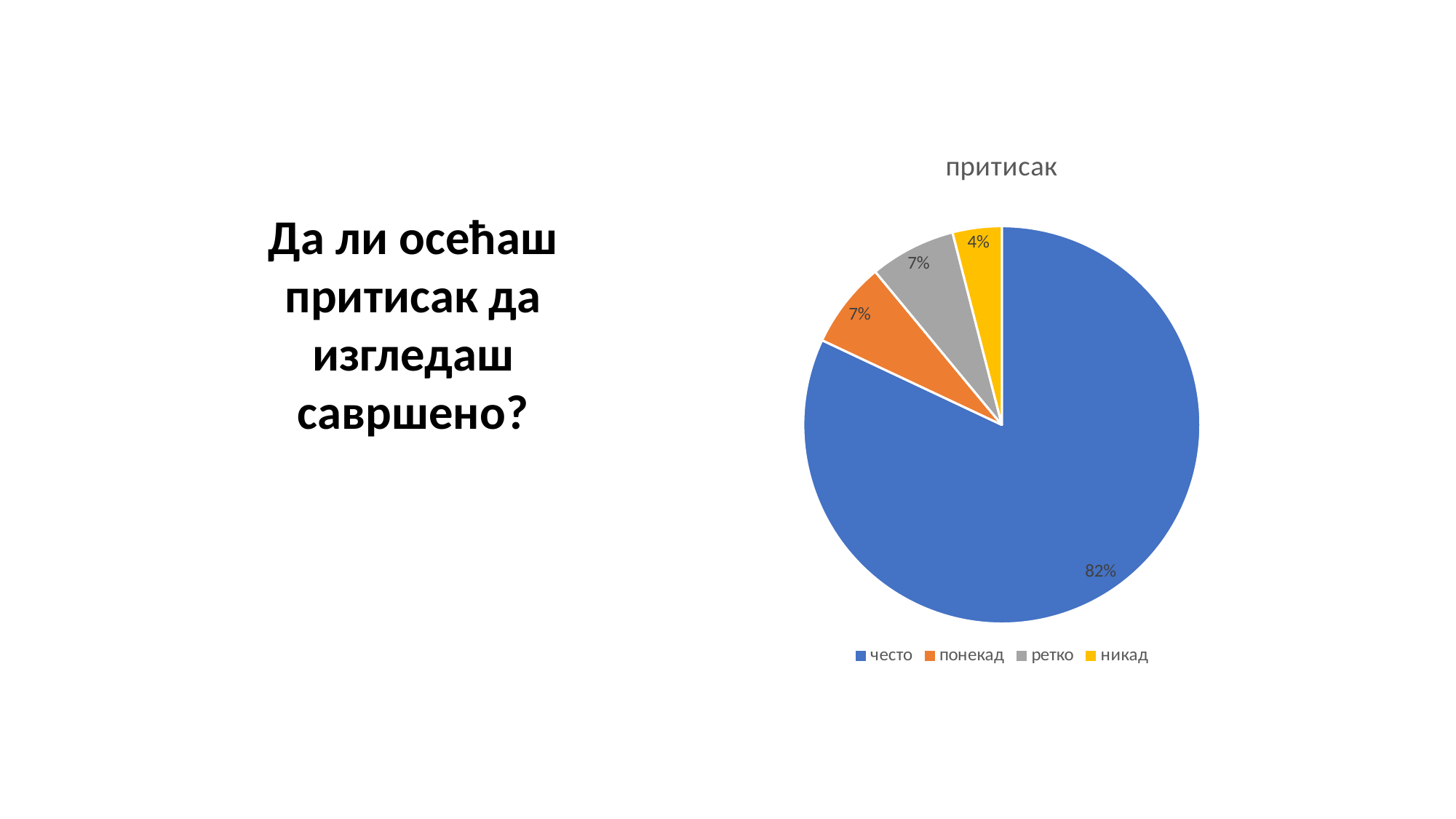
What is the value shown for 'ретко'? 7% What is the title of the chart? притисак Which is larger, the value for 'ретко' or the value for 'никад'? ретко What share of the pie does the 'често' slice take? 82% What kind of chart is shown on the slide? pie chart Which category has the smallest slice of the pie? никад What colour is the 'никад' slice? yellow Which category has the largest slice of the pie? често What is the difference between the values for 'често' and 'никад'? 78% What is the value shown for 'понекад'? 7% How many categories does the legend list? 4 What is the value shown for 'никад'? 4%